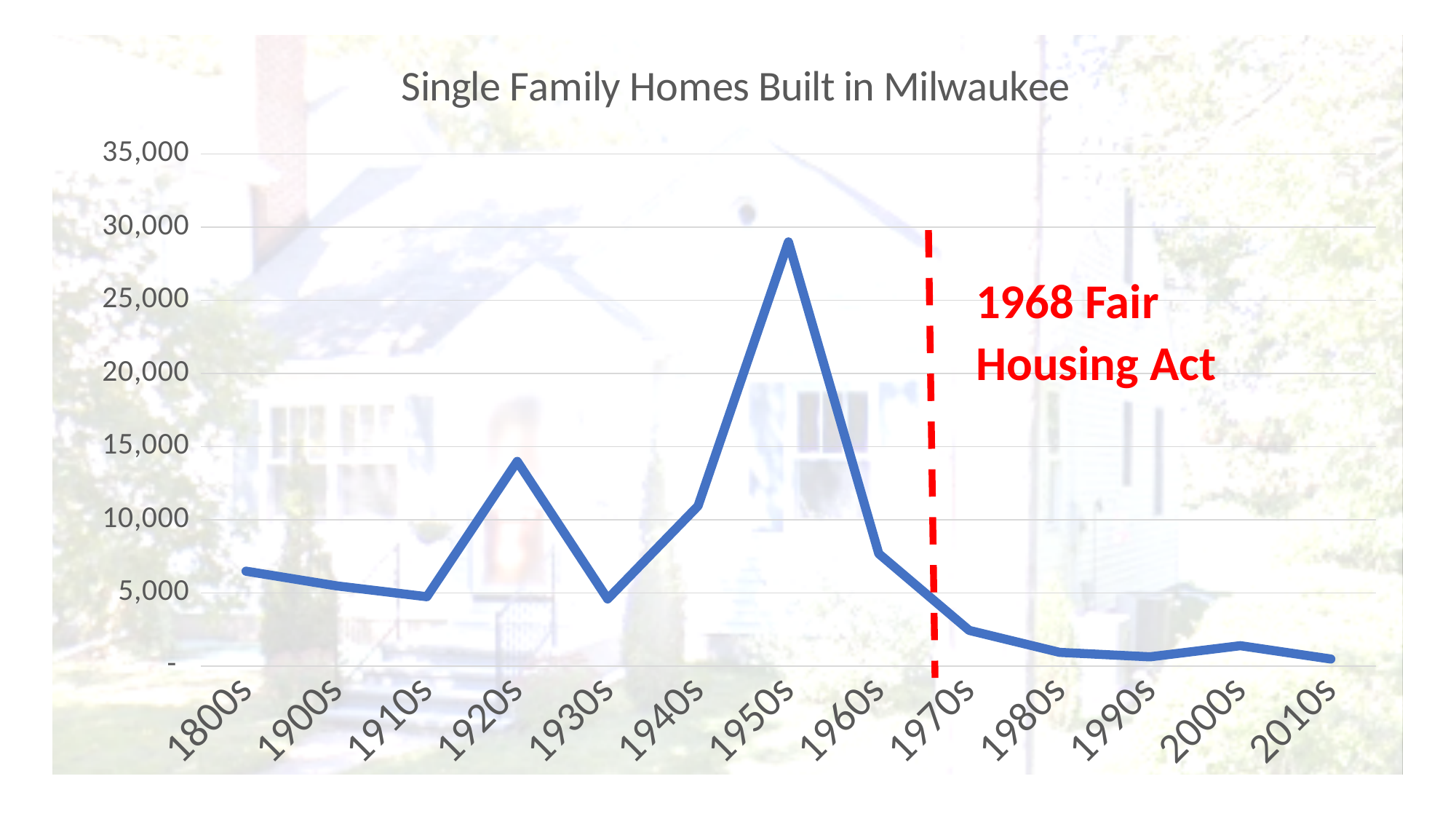
Do the values rise or fall from the 1950s to the 1990s? fall Is the value for the 1920s greater or less than 10,000? greater Is the value for the 1950s greater or less than 25,000? greater Which decade has the highest number of single family homes built? 1950s What is the title of the chart? Single Family Homes Built in Milwaukee What kind of chart is shown on the slide? line chart Is the value for the 1970s greater or less than 5,000? less Which decade has the larger value, the 1800s or the 1910s? 1800s Which decade has the larger value, the 1920s or the 1940s? 1920s How many decade categories are plotted along the x axis? 13 What event does the red dashed vertical line mark on the chart? 1968 Fair Housing Act